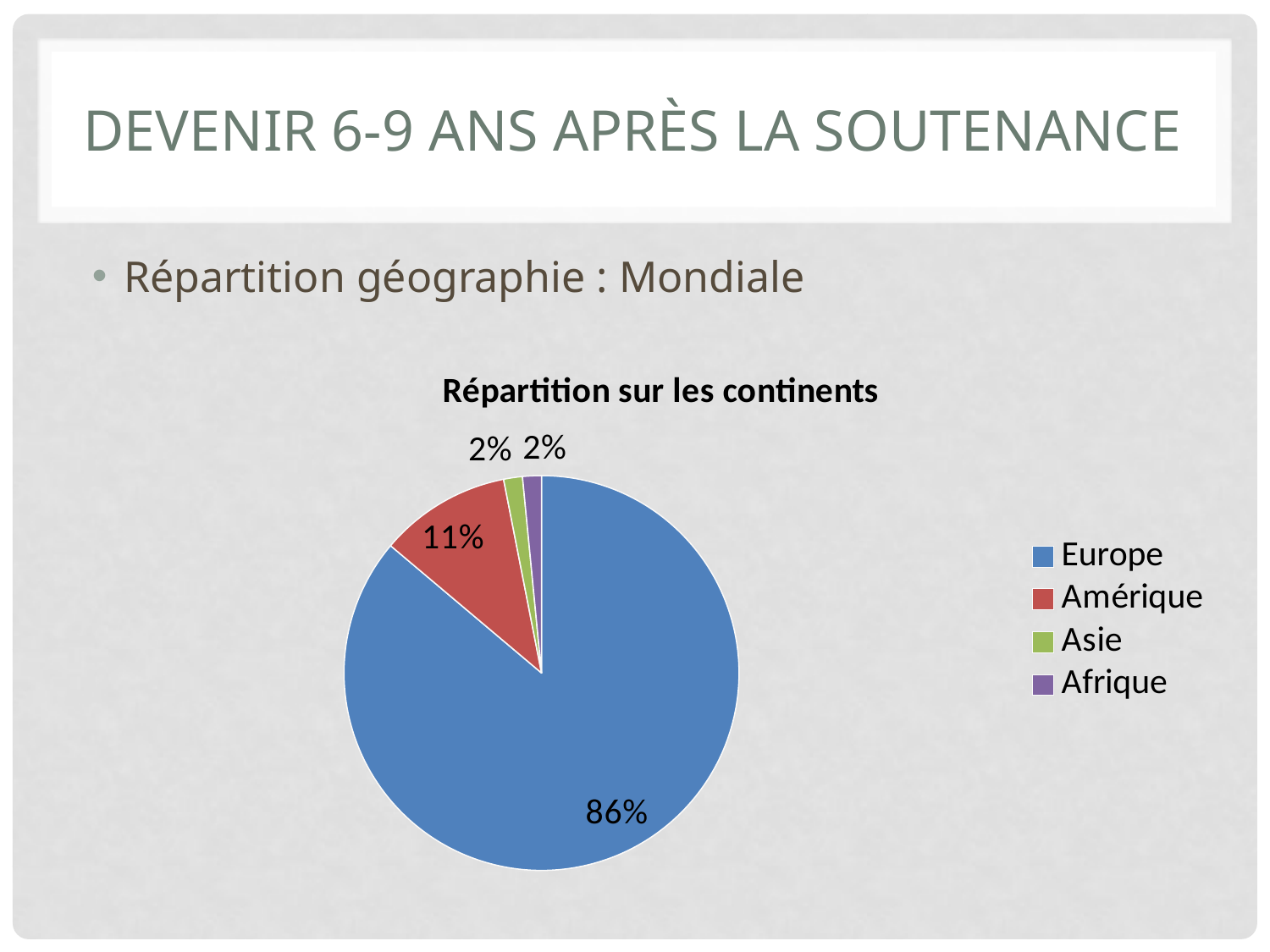
How many categories does the legend list? 4 What share of the pie does Europe represent? 86% What colour is the Europe slice in the pie chart? Blue Is the share for Europe greater or less than 50%? greater What share of the pie does Amérique represent? 11% What share of the pie does Asie represent? 2% What type of chart is shown on the slide? Pie chart Which is larger, the share for Amérique or the share for Asie? Amérique Which continent has the largest share of the pie? Europe What is the difference in percentage points between Europe and Amérique? 75 What is the title of the chart? Répartition sur les continents